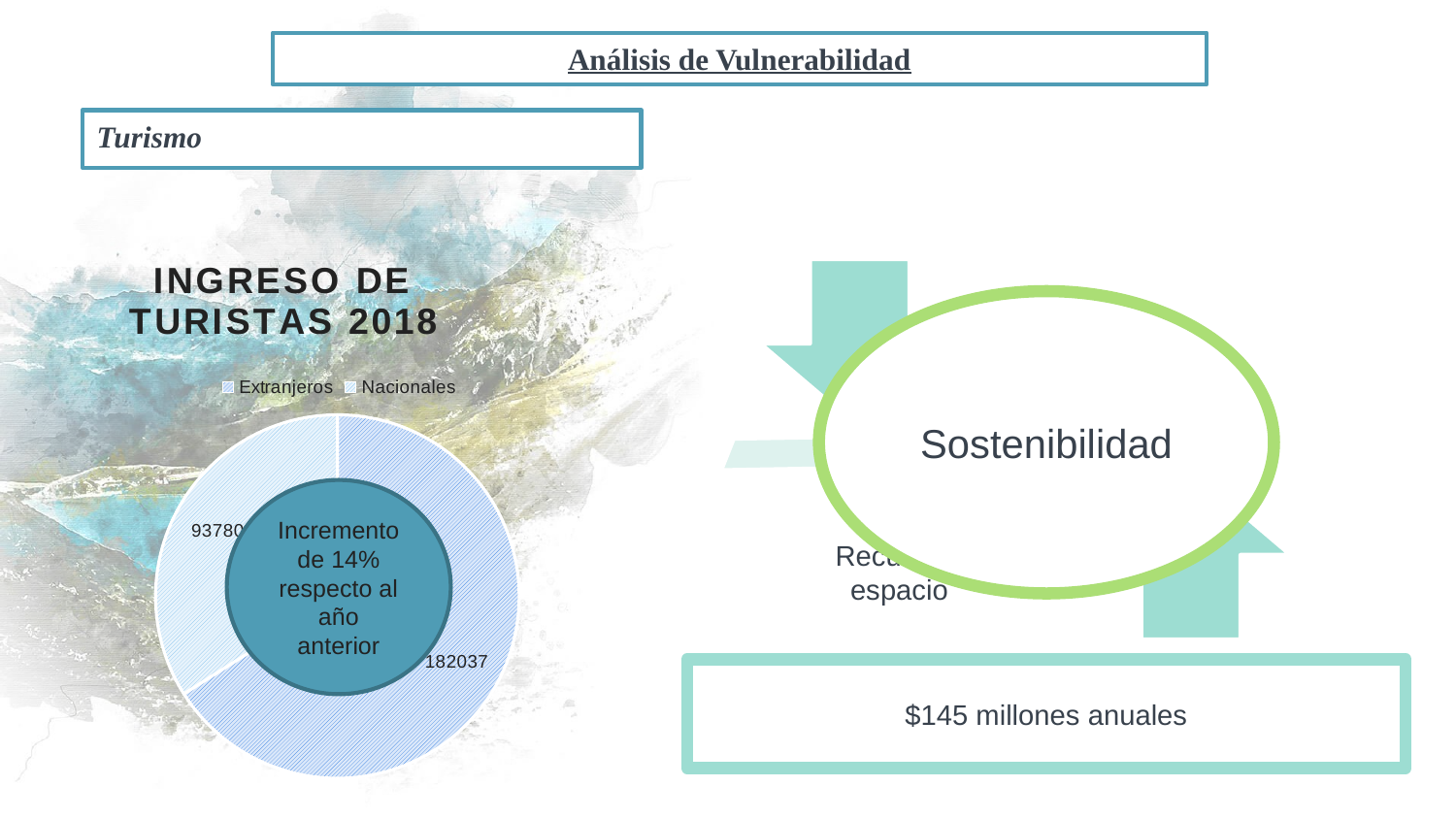
What are the two legend entries of the INGRESO DE TURISTAS 2018 chart? Extranjeros and Nacionales What is the largest data label shown on the INGRESO DE TURISTAS 2018 chart? 182037 What is the smallest data label shown on the INGRESO DE TURISTAS 2018 chart? 93780 What value is labelled on the right-hand slice of the INGRESO DE TURISTAS 2018 chart? 182037 Does the slice labelled 182037 take up more or less than half of the INGRESO DE TURISTAS 2018 chart? more How many slices does the INGRESO DE TURISTAS 2018 chart have? 2 What text is written in the centre of the INGRESO DE TURISTAS 2018 chart? Incremento de 14% respecto al año anterior What is the title of the chart on the left of the slide? INGRESO DE TURISTAS 2018 How many entries does the legend of the INGRESO DE TURISTAS 2018 chart list? 2 What kind of chart is shown under the heading INGRESO DE TURISTAS 2018? pie (doughnut) chart Which slice of the INGRESO DE TURISTAS 2018 chart is larger, the one labelled 182037 or the one labelled 93780? 182037